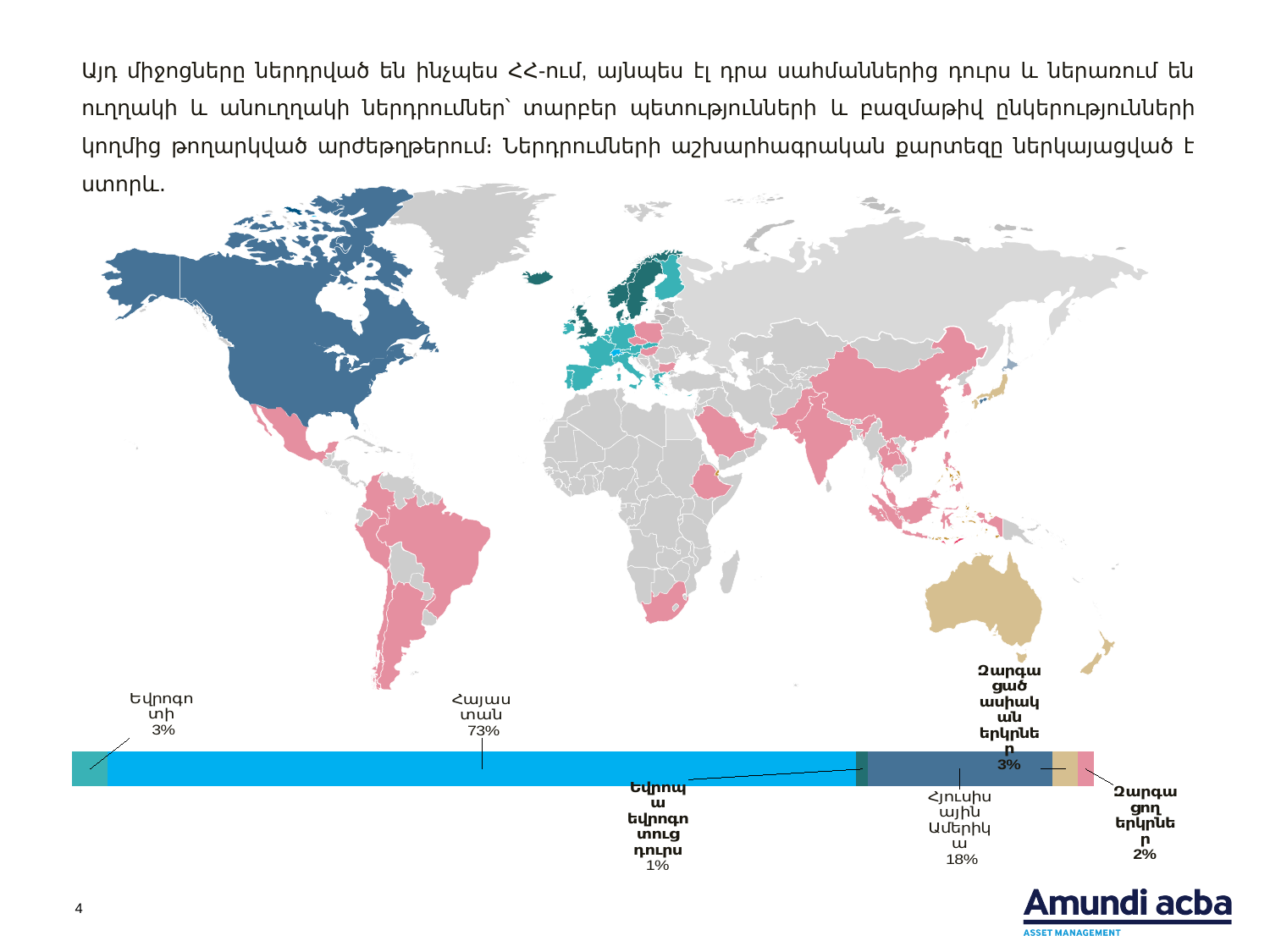
What is the difference between the Հայաստան share and the Հյուսիսային Ամերիկա share? 55% What is the total of all the labelled segments in the stacked bar? 100% Which segment of the stacked bar has the smallest share? Եվրոպա եվրոգոտուց դուրս What kind of chart is shown below the map? Stacked bar chart What share of the stacked bar is labelled Զարգացող երկրներ? 2% How many labelled segments does the stacked bar have? 6 What share of the stacked bar is labelled Եվրոգոտի? 3% What share of the stacked bar is labelled Հայաստան? 73% Which segment of the stacked bar has the largest share? Հայաստան What share of the stacked bar is labelled Եվրոպա եվրոգոտուց դուրս? 1% What share of the stacked bar is labelled Հյուսիսային Ամերիկա? 18% Which is larger, the share for Զարգացած ասիական երկրներ or the share for Զարգացող երկրներ? Զարգացած ասիական երկրներ